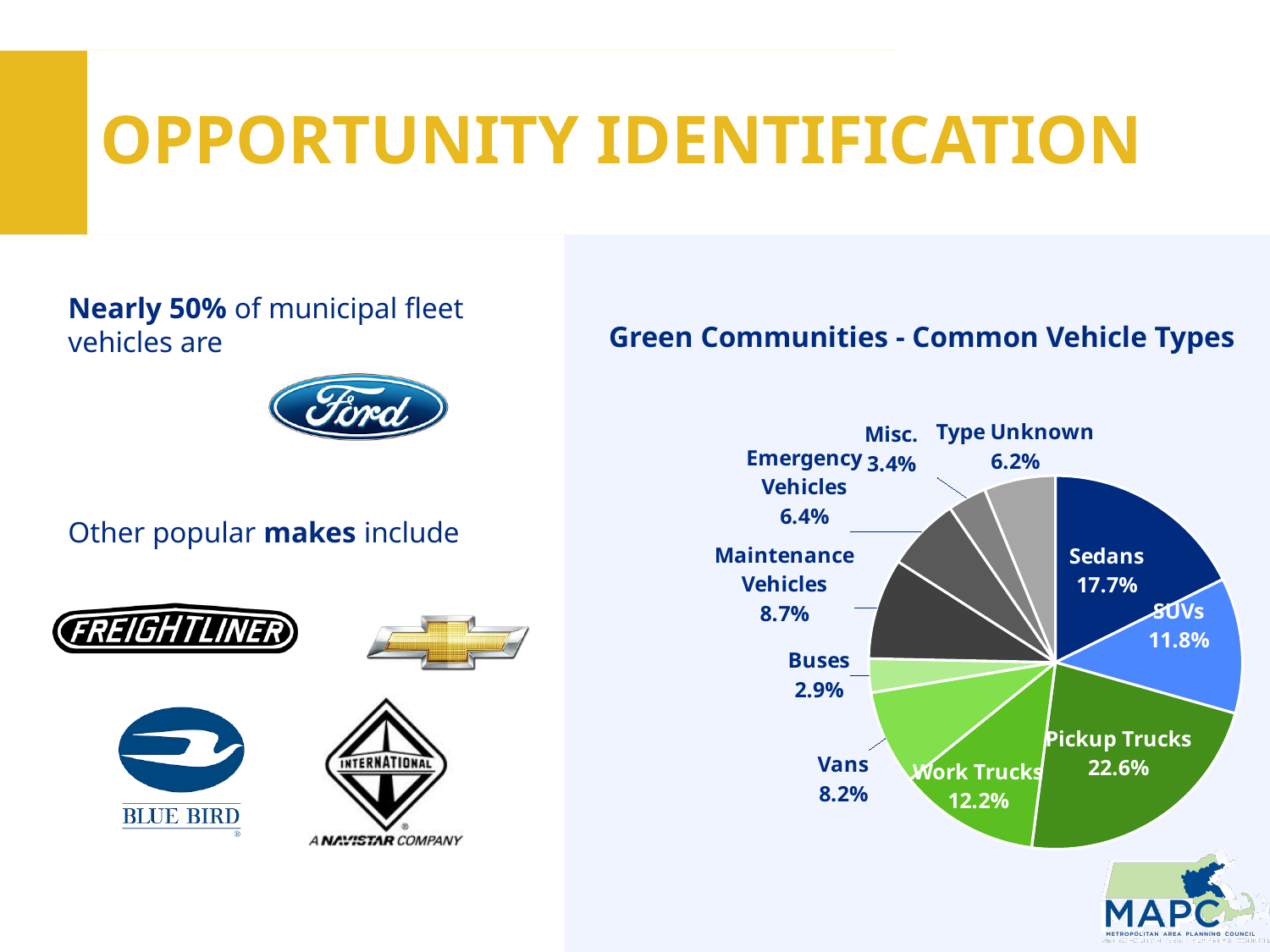
What percentage is shown for Type Unknown? 6.2% What percentage of vehicles are Pickup Trucks? 22.6% Which has a larger share, Work Trucks or SUVs? Work Trucks What is the title of the chart? Green Communities - Common Vehicle Types Which has a larger share, Vans or Emergency Vehicles? Vans What type of chart is shown on the slide? Pie chart What percentage of vehicles are Sedans? 17.7% Which vehicle type has the smallest share of the pie? Buses What share of the pie is Maintenance Vehicles? 8.7% What is the difference in percentage points between Pickup Trucks and Sedans? 4.9 How many vehicle type categories are shown in the pie chart? 10 Which vehicle type has the largest share of the pie? Pickup Trucks